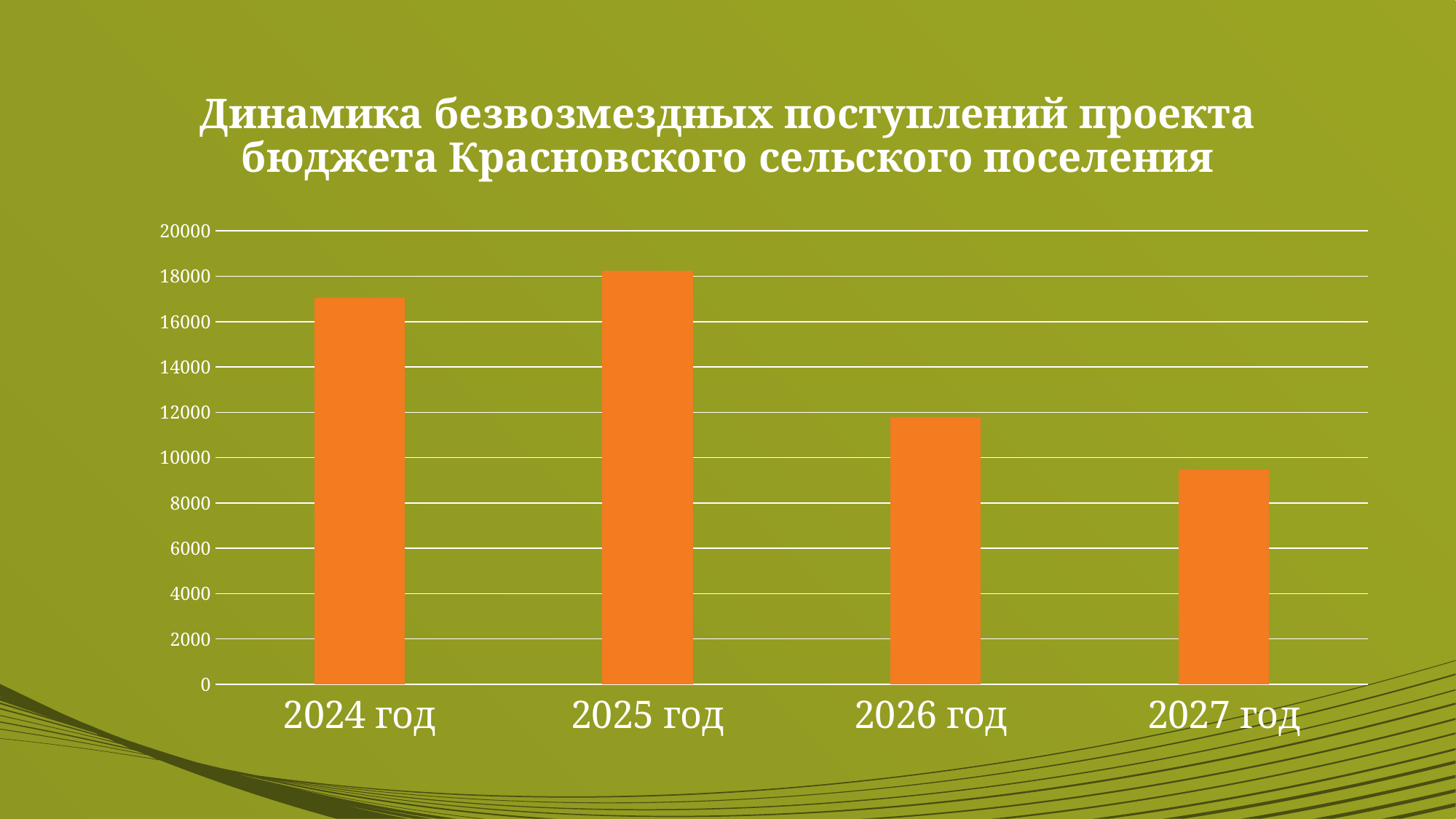
Which is larger, the value for 2024 год or the value for 2026 год? 2024 год Which is larger, the value for 2026 год or the value for 2027 год? 2026 год Do the values rise or fall from 2025 год to 2027 год? fall Is the value for 2026 год greater or less than 14000? less Is the value for 2027 год greater or less than 10000? less Which year has the highest value? 2025 год What kind of chart is shown on the slide? bar chart Is the value for 2024 год greater or less than 16000? greater How many years (categories) are shown on the x axis? 4 What is the title of the chart? Динамика безвозмездных поступлений проекта бюджета Красновского сельского поселения Which year has the lowest value? 2027 год